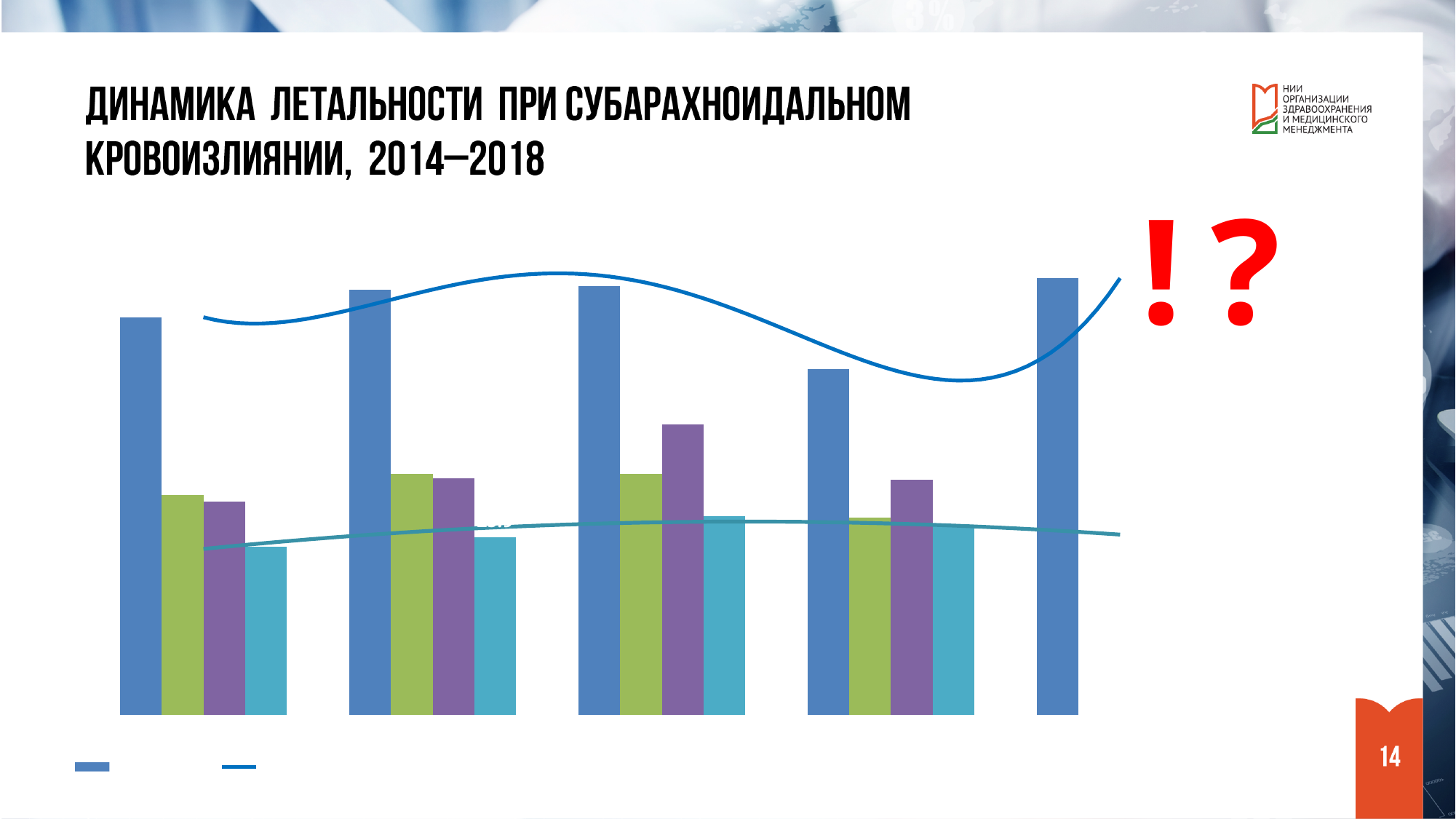
Which group has the shortest dark blue bar? the fourth group How many groups of bars are plotted in the chart? 5 How many different bar colours are used in the chart? 4 Which group of bars contains only a single bar? the fifth (rightmost) group Which group has the tallest dark blue bar? the fifth (rightmost) group What kind of chart is shown on the slide? bar chart Is the dark blue bar in the fourth group taller or shorter than the dark blue bar in the third group? shorter In the third group, is the purple bar taller or shorter than the green bar? taller What is the title of the slide containing the chart? ДИНАМИКА ЛЕТАЛЬНОСТИ ПРИ СУБАРАХНОИДАЛЬНОМ КРОВОИЗЛИЯНИИ, 2014–2018 In the first group, is the green bar taller or shorter than the purple bar? taller